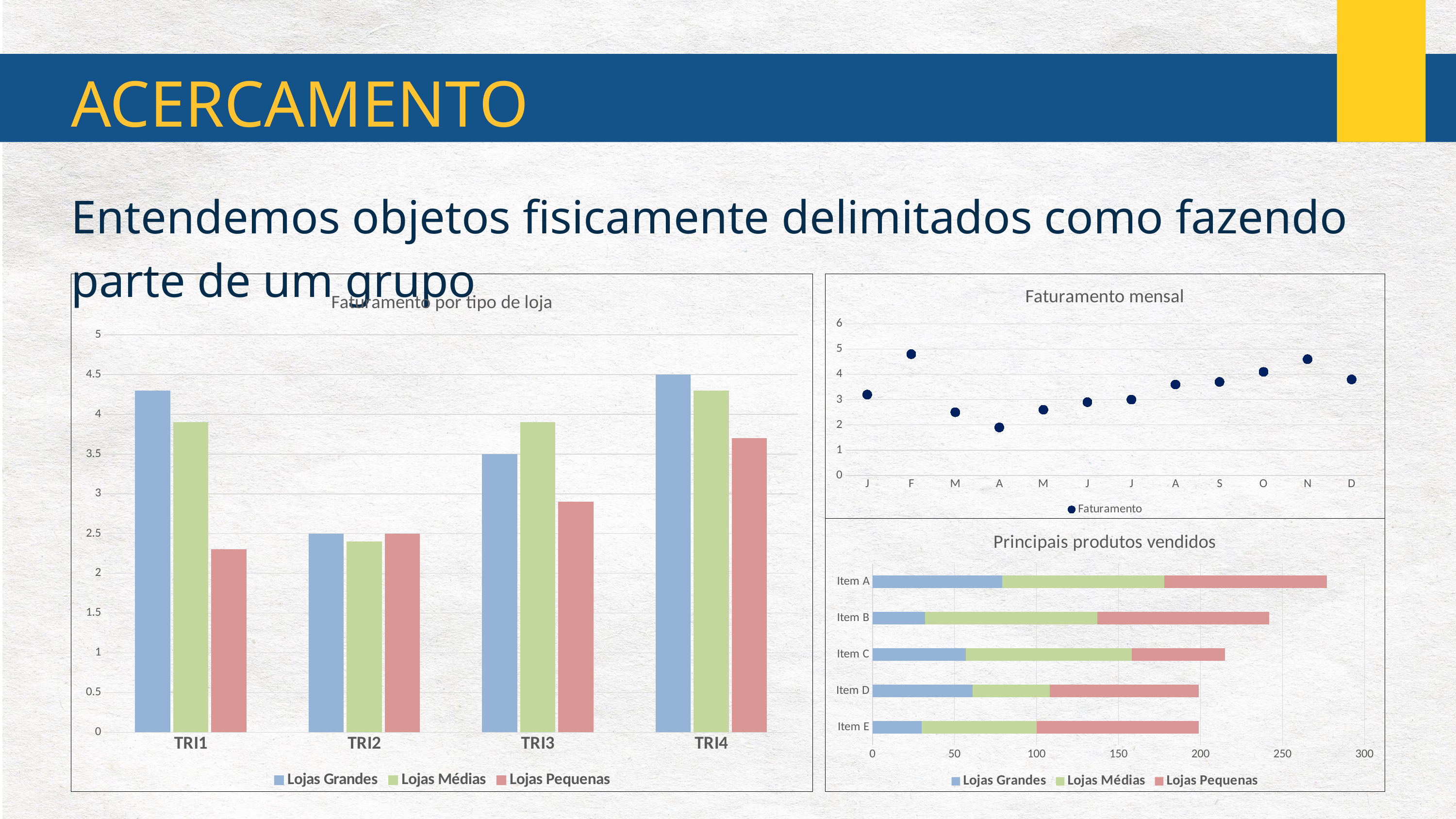
In 'Faturamento por tipo de loja', which quarter has the highest value for Lojas Grandes? TRI4 In 'Faturamento mensal', how many data points are plotted? 12 In 'Principais produtos vendidos', which item has the longest total bar? Item A In 'Faturamento por tipo de loja', which quarter has the lowest value for Lojas Pequenas? TRI1 In 'Faturamento por tipo de loja', is the value for Lojas Pequenas in TRI1 greater or less than 2.5? less In 'Faturamento por tipo de loja', how many series does the legend list? 3 In 'Faturamento por tipo de loja', in TRI1 which is larger, Lojas Grandes or Lojas Médias? Lojas Grandes In 'Faturamento mensal', do the values rise or fall from A to N? rise In 'Faturamento por tipo de loja', what is the value for Lojas Grandes in TRI2? 2.5 In 'Faturamento mensal', which month has the lowest value? A What kind of chart is 'Faturamento por tipo de loja'? bar chart In 'Faturamento por tipo de loja', how many quarters are shown on the x axis? 4